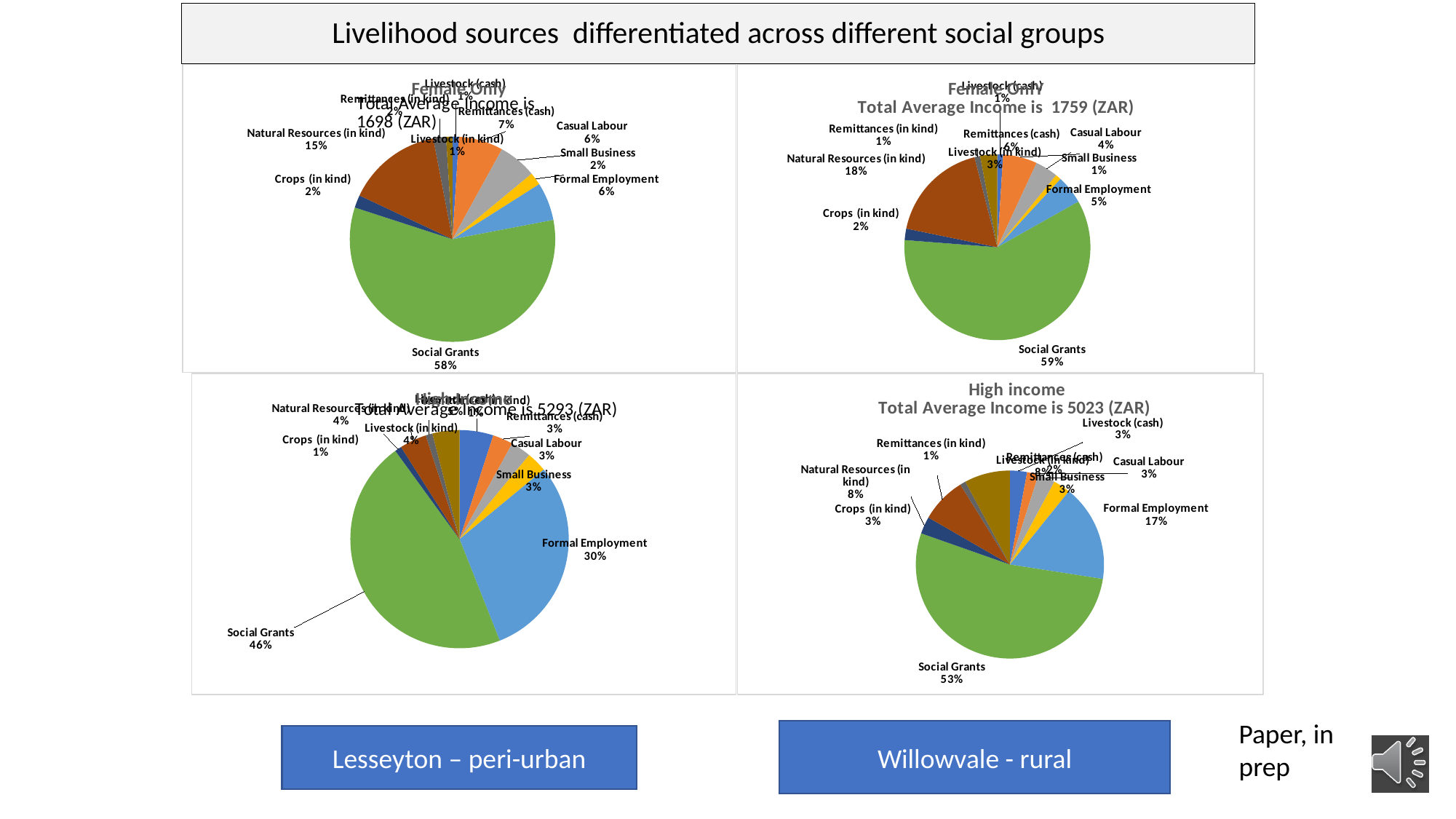
In the top-right pie chart (Willowvale, Female Only), which is larger: Remittances (cash) or Casual Labour? Remittances (cash) In the bottom-left pie chart (Lesseyton, High income), what share is Formal Employment? 30% What is the Total Average Income stated for the Willowvale High income chart (bottom-right)? 5023 (ZAR) In the bottom-left pie chart (Lesseyton, High income), what is the difference between the Social Grants share and the Formal Employment share? 16% In the bottom-right pie chart (Willowvale, High income), what share is Formal Employment? 17% What is the Total Average Income stated for the Lesseyton Female Only chart (top-left)? 1698 (ZAR) In the top-right pie chart (Willowvale, Female Only), what share is Formal Employment? 5% What kind of charts are shown on the slide? Pie charts In the top-left pie chart (Lesseyton, Female Only), which category has the largest share? Social Grants